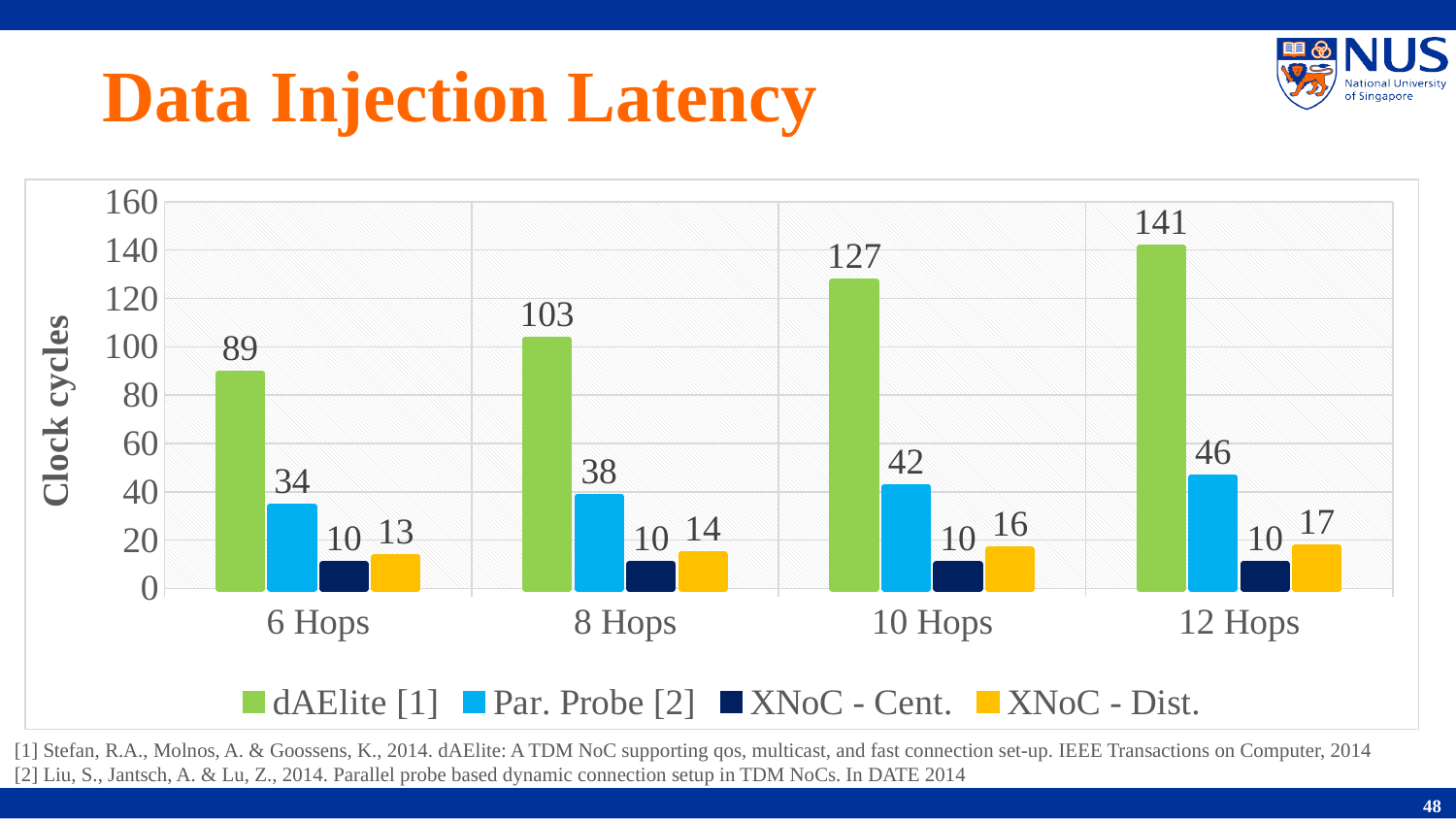
At which hop count does dAElite [1] have its highest value? 12 Hops What is the value for Par. Probe [2] at 8 Hops? 38 What is the value for dAElite [1] at 12 Hops? 141 Does the value for Par. Probe [2] rise or fall as the number of hops increases? Rise What kind of chart is shown on the slide? Bar chart Which series has the lowest value at 12 Hops? XNoC - Cent. Which is larger at 6 Hops: Par. Probe [2] or XNoC - Dist.? Par. Probe [2] How many hop-count categories are shown on the x axis? 4 What is the difference between dAElite [1] and Par. Probe [2] at 10 Hops? 85 What is the value for XNoC - Cent. at 6 Hops? 10 How many series does the legend list? 4 What is the value for XNoC - Dist. at 10 Hops? 16